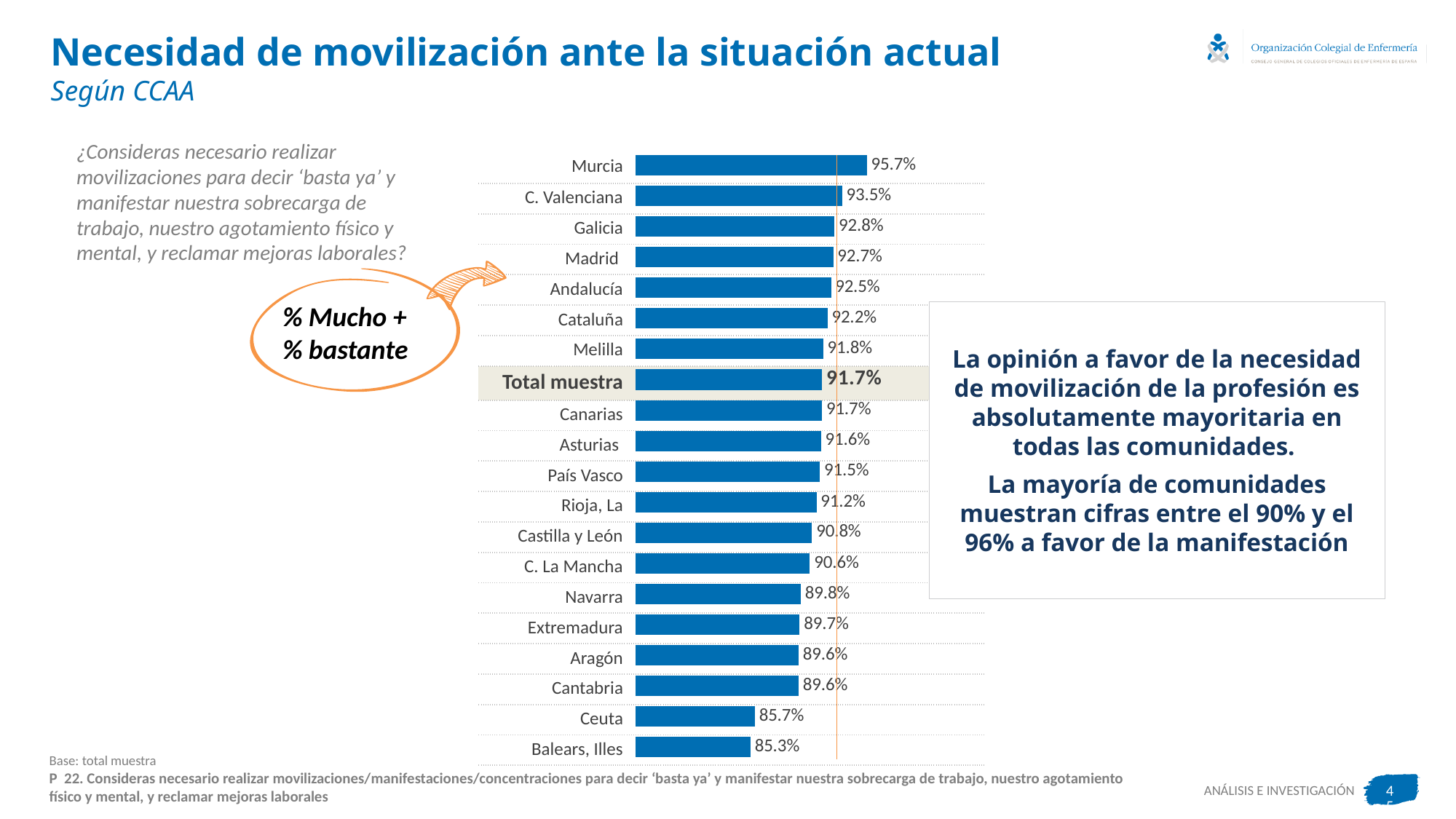
Which category has the lowest value? Balears, Illes What label is shown in the orange circle next to the chart? % Mucho + % bastante Which has a larger value, Madrid or Navarra? Madrid What is the value for Murcia? 95.7% What kind of chart is shown on the slide? Bar chart Which category has the highest value? Murcia What is the difference between the values for C. Valenciana and Galicia? 0.7% What is the difference between the values for Murcia and Balears, Illes? 10.4% How many bars are shown in the chart, including Total muestra? 20 What is the value for Total muestra? 91.7% What is the value for Castilla y León? 90.8% What is the value for Ceuta? 85.7%